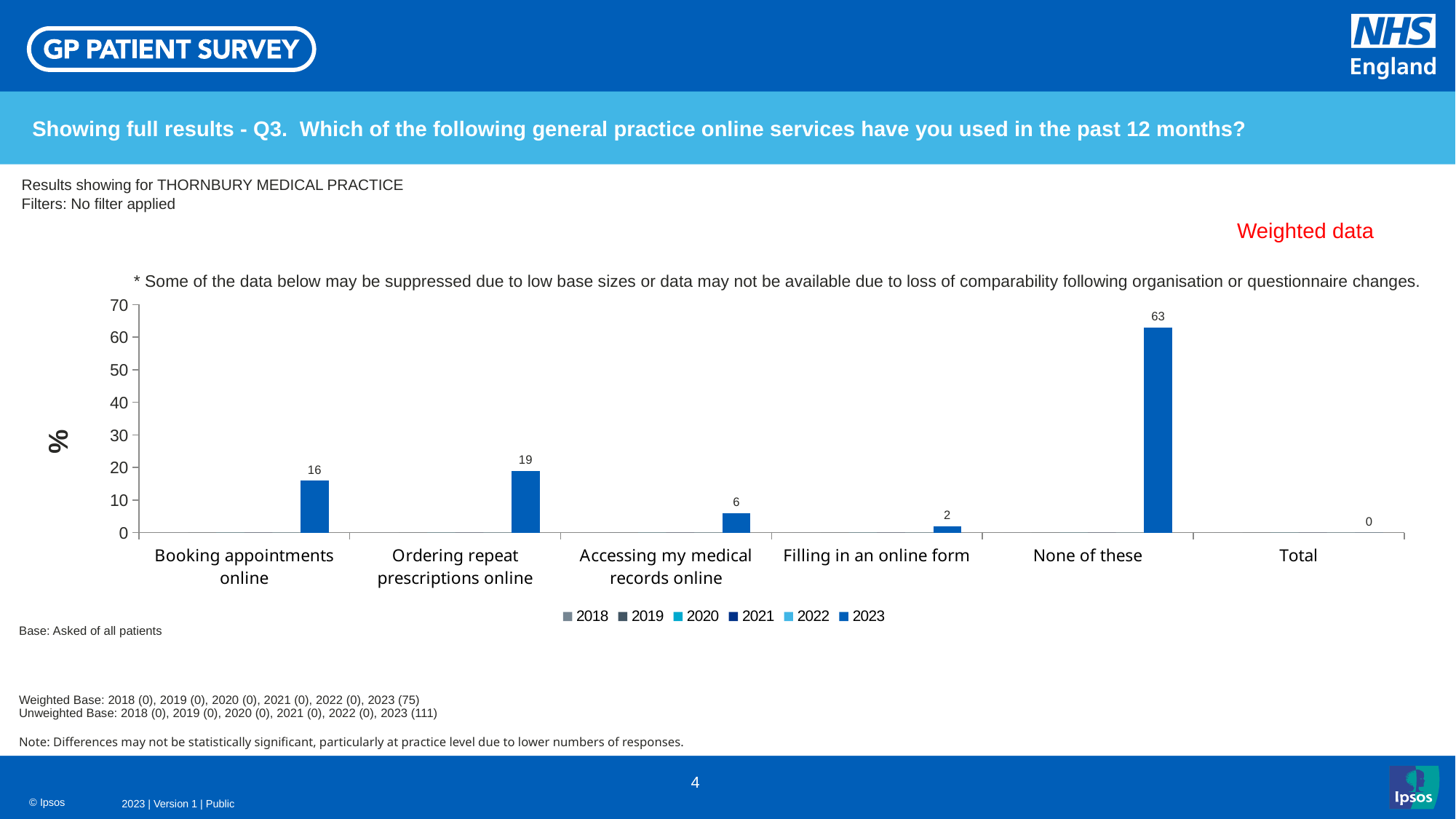
How many series does the legend list? 6 What is the difference between the 2023 values for Ordering repeat prescriptions online and Booking appointments online? 3 Which is larger in 2023: Accessing my medical records online or Filling in an online form? Accessing my medical records online Which category has the highest 2023 value? None of these What is the 2023 value for Ordering repeat prescriptions online? 19 What is the 2023 value for Accessing my medical records online? 6 What is the 2023 value for Filling in an online form? 2 What is the 2023 value for None of these? 63 How many categories are shown on the x axis? 6 What kind of chart is shown on the slide? Bar chart What is the 2023 value for Booking appointments online? 16